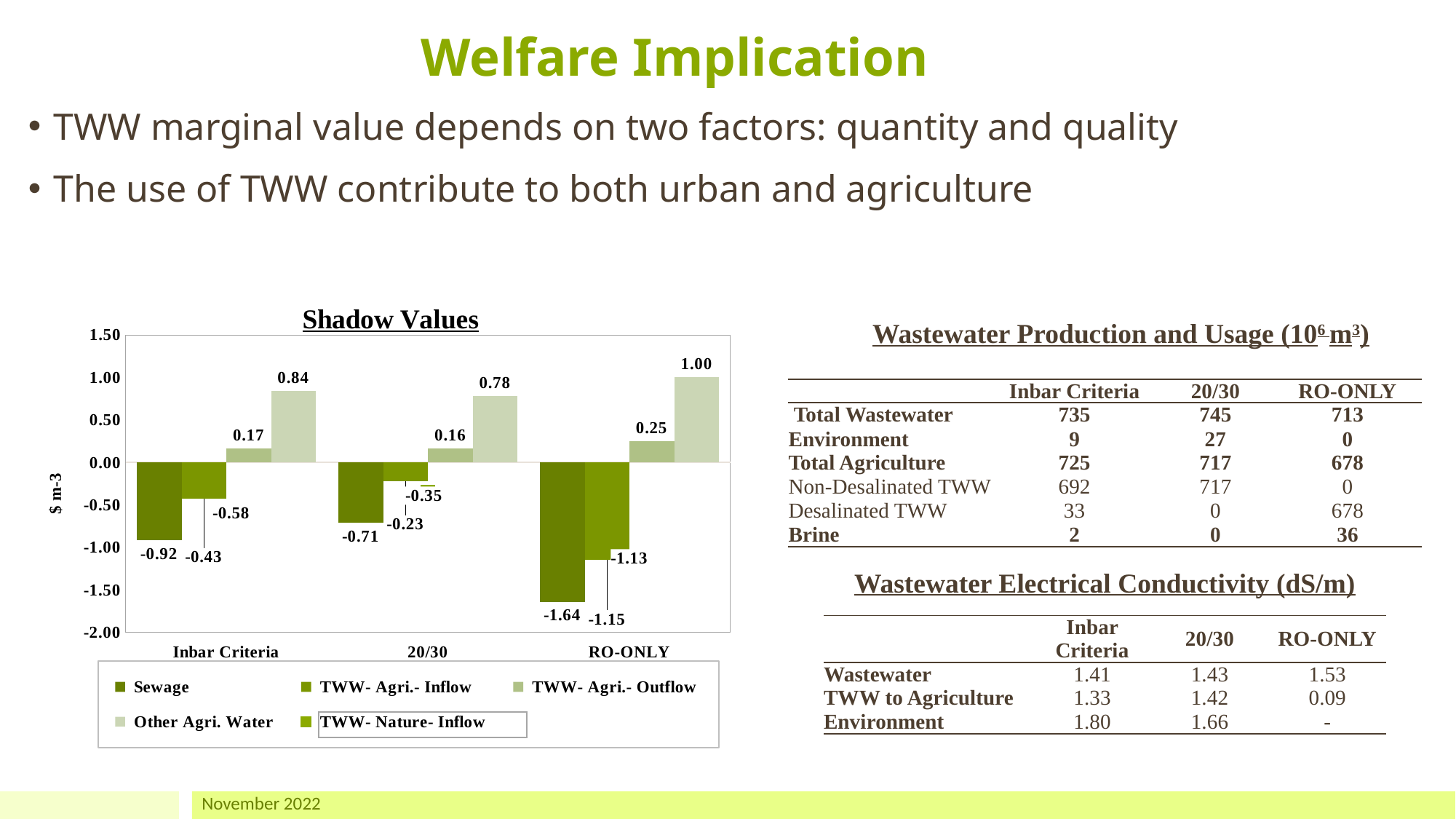
What is the value for Sewage under Inbar Criteria in the Shadow Values chart? -0.92 Which is larger in the Shadow Values chart: TWW- Agri.- Outflow under Inbar Criteria or under RO-ONLY? RO-ONLY What is the value for Sewage under RO-ONLY in the Shadow Values chart? -1.64 Is the Sewage value for RO-ONLY in the Shadow Values chart greater or less than -1.50? less How many series does the legend of the Shadow Values chart list? 5 What type of chart is the Shadow Values chart? Bar chart What is the difference between the Other Agri. Water values for Inbar Criteria and 20/30 in the Shadow Values chart? 0.06 What is the value for TWW- Agri.- Outflow under 20/30 in the Shadow Values chart? 0.16 How many categories are shown on the x axis of the Shadow Values chart? 3 In which category is the Sewage value lowest in the Shadow Values chart? RO-ONLY What is the value for Other Agri. Water under RO-ONLY in the Shadow Values chart? 1.00 In which category does Other Agri. Water reach its highest value in the Shadow Values chart? RO-ONLY